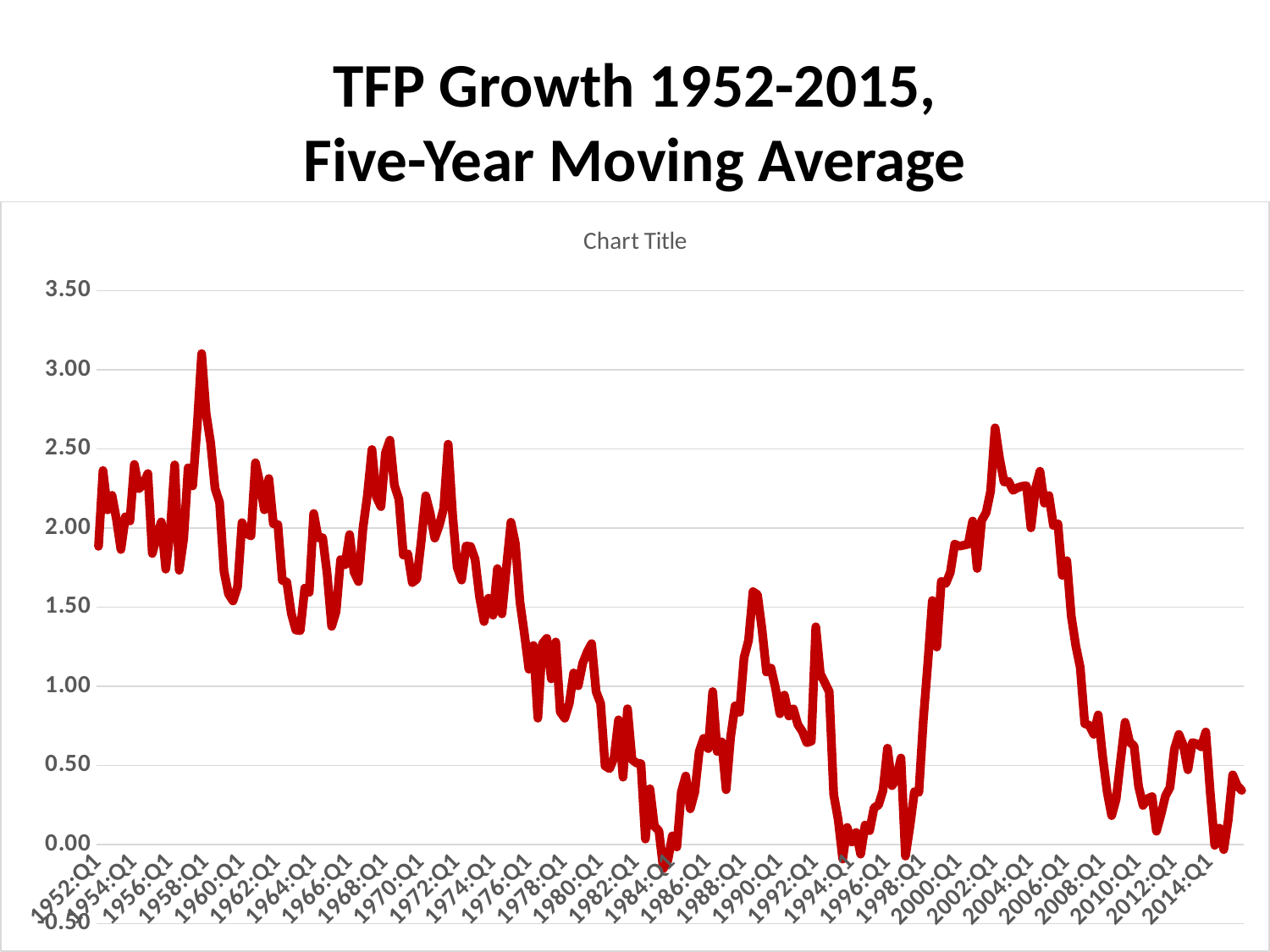
Is the value at 1996:Q1 greater or less than 0.50? greater Which is larger, the value at 2002:Q1 or the value at 2014:Q1? 2002:Q1 Which is larger, the value at 1958:Q1 or the value at 1984:Q1? 1958:Q1 Is the value at 2002:Q1 greater or less than 2.00? greater What kind of chart is shown on the slide? Line chart What colour is the plotted line? Red Is the value at 1984:Q1 greater or less than 0.50? less Overall, do the values rise or fall from 1952 to 2015? Fall What is the title shown at the top of the slide above the chart? TFP Growth 1952-2015, Five-Year Moving Average